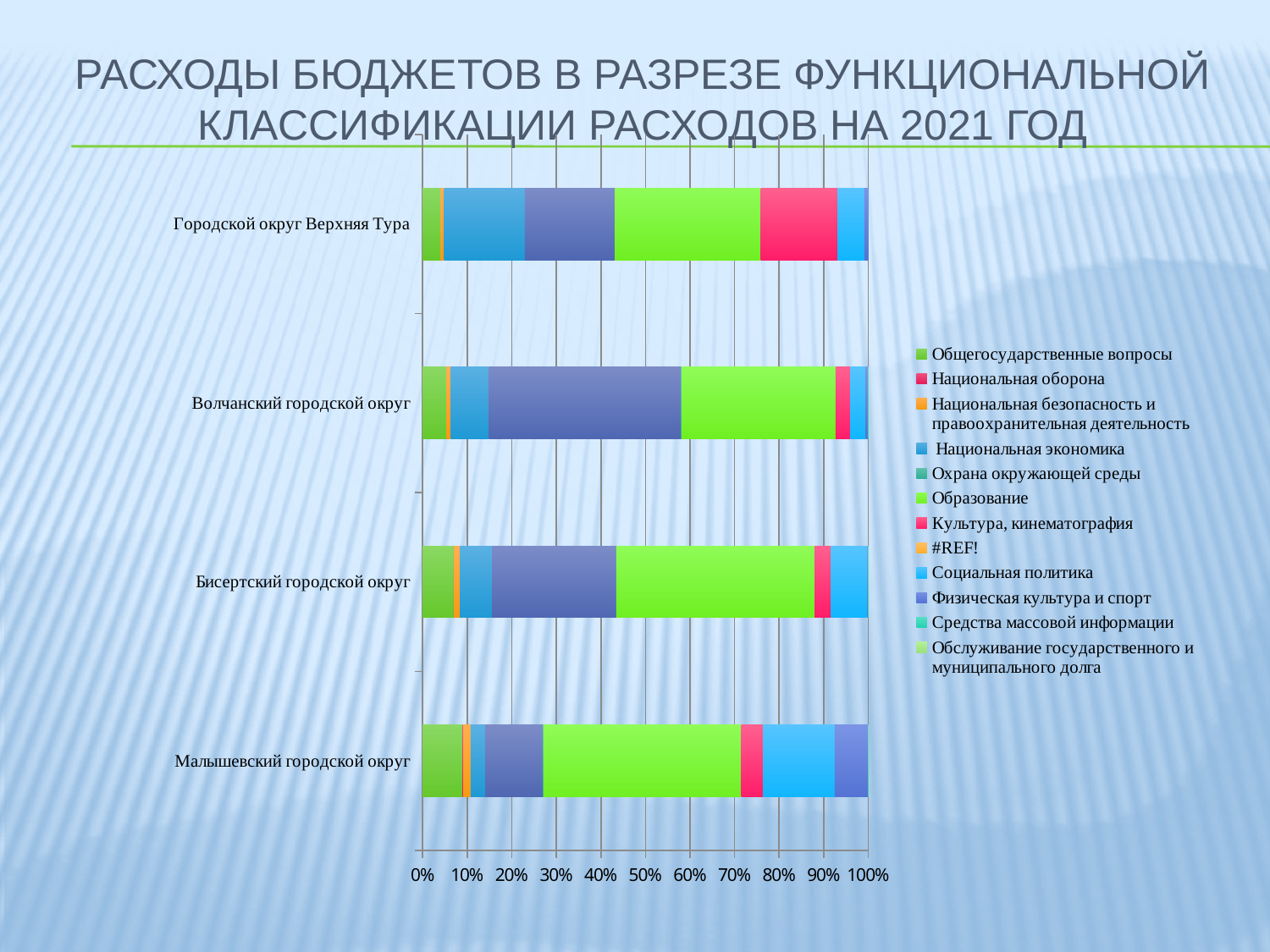
Which district has the largest share for Социальная политика? Малышевский городской округ What kind of chart is shown on the slide? Stacked bar chart Which district has the largest share for Физическая культура и спорт? Малышевский городской округ How many municipal districts (categories) are plotted on the chart? 4 Which is larger: the Образование share in Бисертский городской округ or in Городской округ Верхняя Тура? Бисертский городской округ Is the value for Социальная политика in Малышевский городской округ greater or less than 10%? greater How many series does the legend list? 12 Is the value for Культура, кинематография in Городской округ Верхняя Тура greater or less than 10%? greater What is the title of the slide containing the chart? РАСХОДЫ БЮДЖЕТОВ В РАЗРЕЗЕ ФУНКЦИОНАЛЬНОЙ КЛАССИФИКАЦИИ РАСХОДОВ НА 2021 ГОД Is the value for Общегосударственные вопросы in Малышевский городской округ greater or less than 10%? less Which legend entry shows an error reference instead of a category name? #REF!